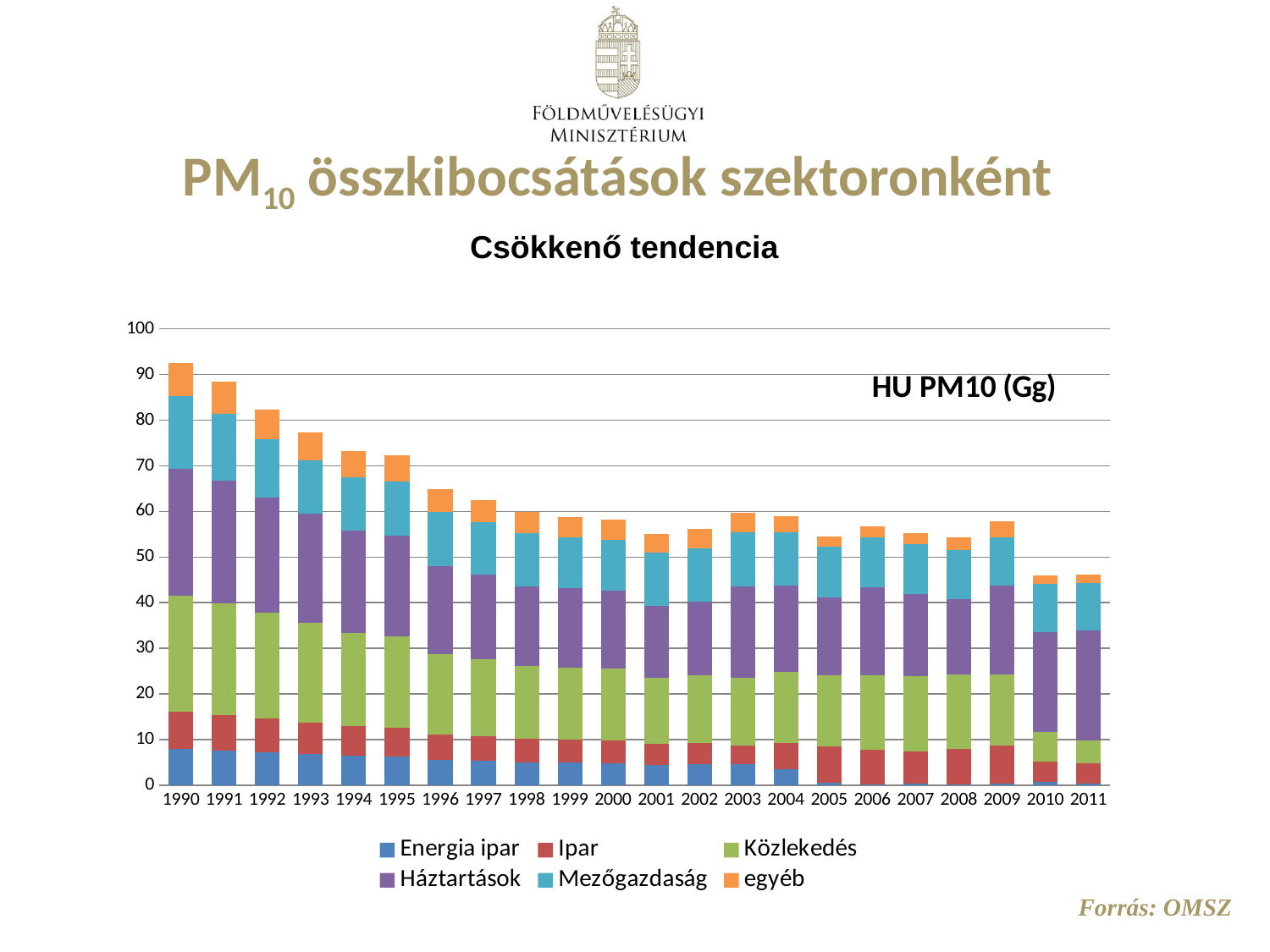
Is the total stacked bar for 1990 greater or less than 90? greater Which legend entry is shown in purple? Háztartások Which total is larger, 1990 or 2011? 1990 Which year has the highest total stacked bar? 1990 Do the total emissions generally rise or fall from 1990 to 2011? fall How many series does the legend list? 6 What is the title printed inside the chart area? HU PM10 (Gg) Is the total stacked bar for 1996 greater or less than 60? greater How many years are shown on the x axis? 22 Is the total stacked bar for 2001 greater or less than 60? less What kind of chart is shown on the slide? bar chart